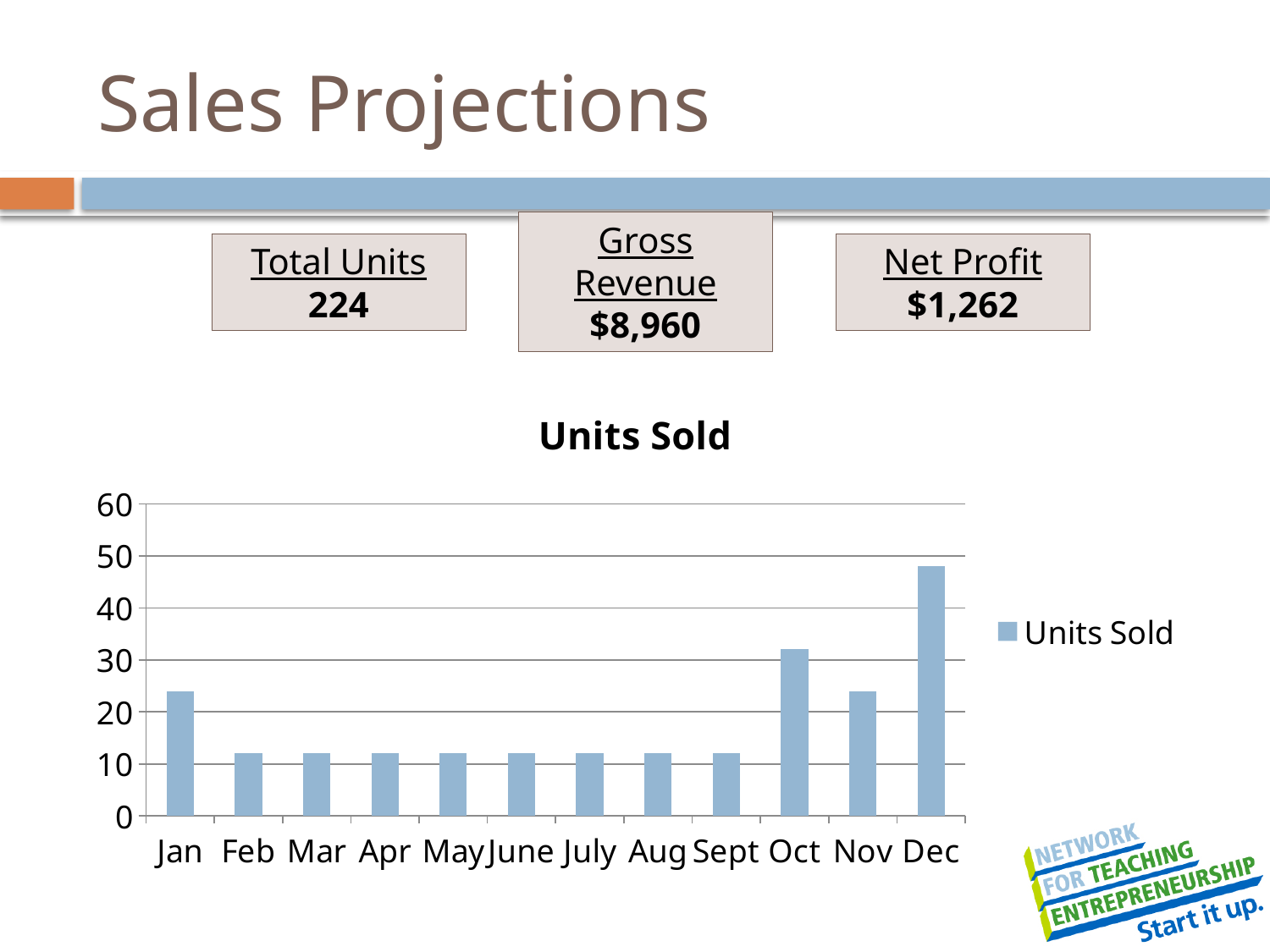
Which month has the highest units sold? Dec Which month has more units sold, Oct or Nov? Oct Is the value for Dec greater or less than 40? greater Is the value for Feb greater or less than 20? less Which month has more units sold, Dec or Jan? Dec Is the value for Oct greater or less than 40? less How many series does the chart legend list? 1 What is the title of the chart? Units Sold Do the units sold rise or fall from Jan to Feb? fall What kind of chart is shown on the slide? bar chart How many months are shown on the x axis of the chart? 12